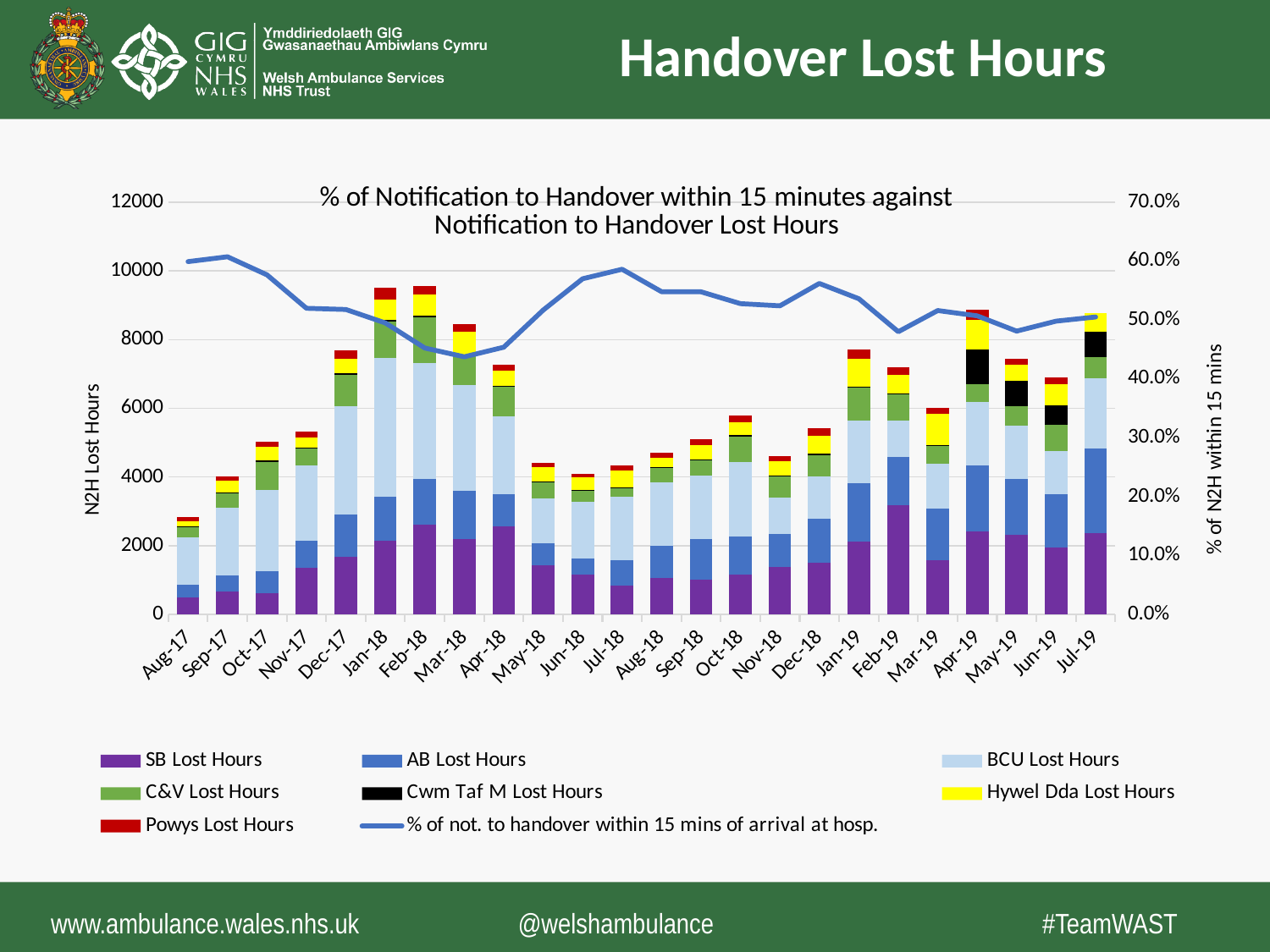
Does the % of not. to handover within 15 mins line rise or fall from Aug-17 to Mar-18? fall Which month has the lowest total N2H Lost Hours bar? Aug-17 Is the total N2H Lost Hours bar for Aug-17 greater or less than 4000? less How many series does the chart's legend list? 8 What kind of chart is shown on the slide? Stacked bar chart with a line Is the total N2H Lost Hours bar for Jan-18 greater or less than 8000? greater Which month has the larger total N2H Lost Hours bar, Dec-18 or Jan-19? Jan-19 Which colour represents Hywel Dda Lost Hours in the chart? Yellow How many months are shown along the x axis of the chart? 24 What is the title of the chart? % of Notification to Handover within 15 minutes against Notification to Handover Lost Hours Is the % of not. to handover within 15 mins line value for Mar-18 greater or less than 50.0%? less